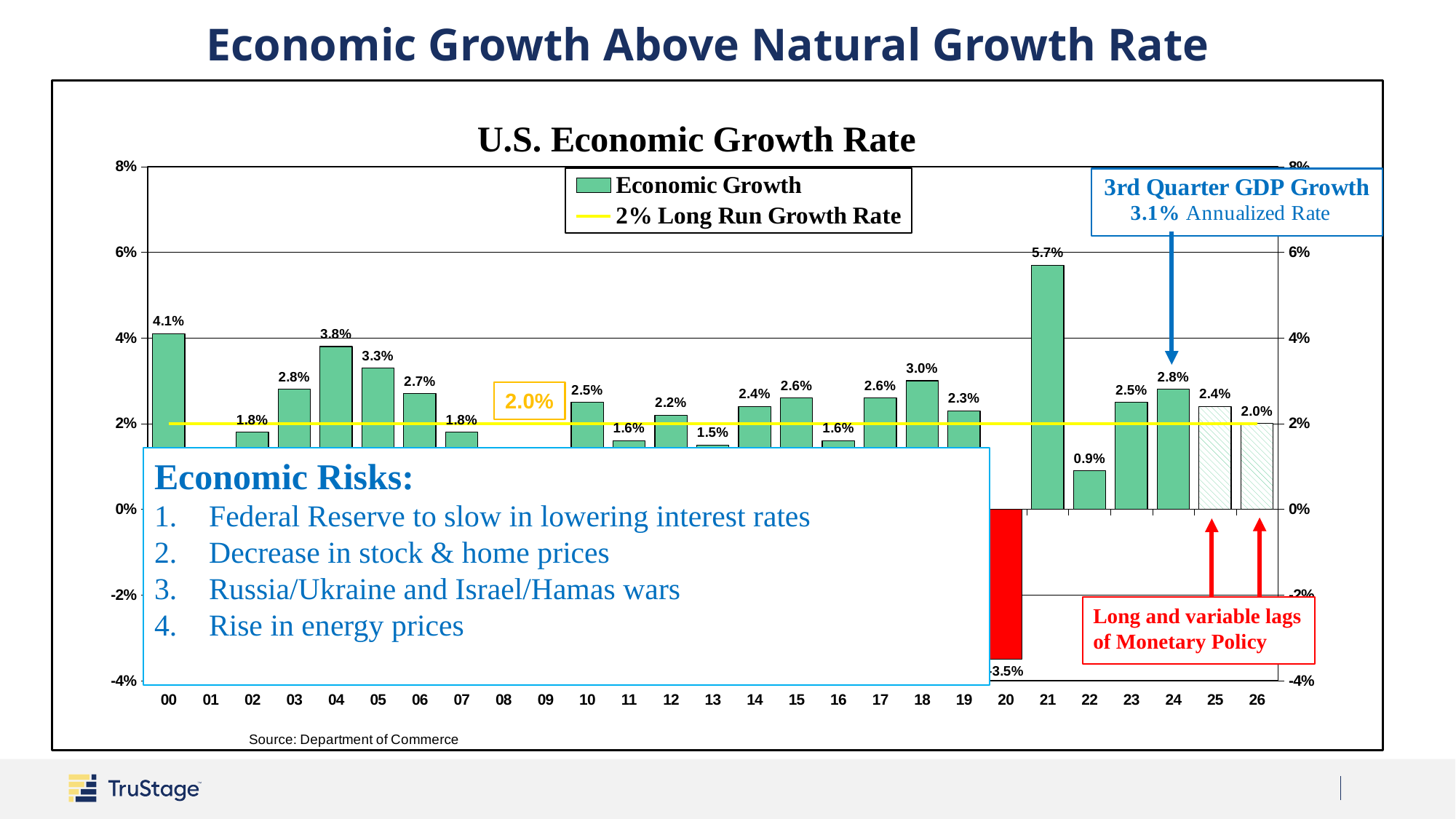
How many series does the legend list? 2 Which year has a higher economic growth rate, 04 or 05? 04 What is the difference between the economic growth rates for 18 and 19? 0.7 percentage points Which year has the highest economic growth rate in the chart? 21 What kind of chart is used to show the economic growth values? Bar chart What is the economic growth rate shown for 25? 2.4% What is the economic growth rate shown for 22? 0.9% Which year has the lowest economic growth rate in the chart? 20 What is the economic growth rate shown for 20? -3.5% What is the difference between the economic growth rates for 21 and 22? 4.8 percentage points What is the title of the chart? U.S. Economic Growth Rate What is the economic growth rate shown for 21? 5.7%